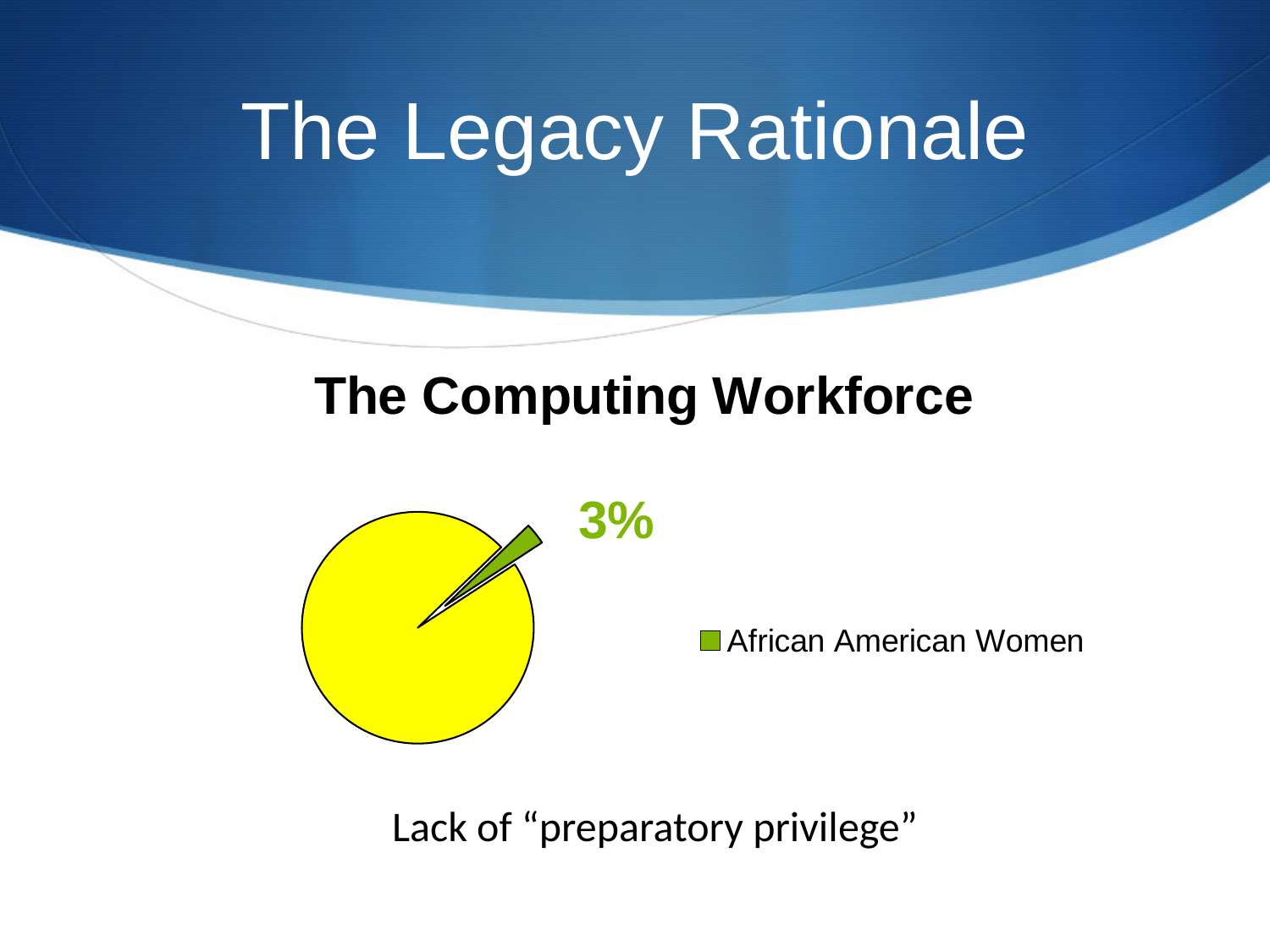
What value is printed next to the green slice of the pie chart? 3% What colour is the African American Women slice in the pie chart? green How many entries does the legend of the pie chart list? 1 What kind of chart is shown on the slide? pie chart Which slice of the pie is larger, the yellow slice or the green slice? the yellow slice How many slices does the pie chart have? 2 What share of the pie does the African American Women slice represent? 3% What is the title shown above the pie chart? The Computing Workforce Which slice of the pie is the smallest? African American Women